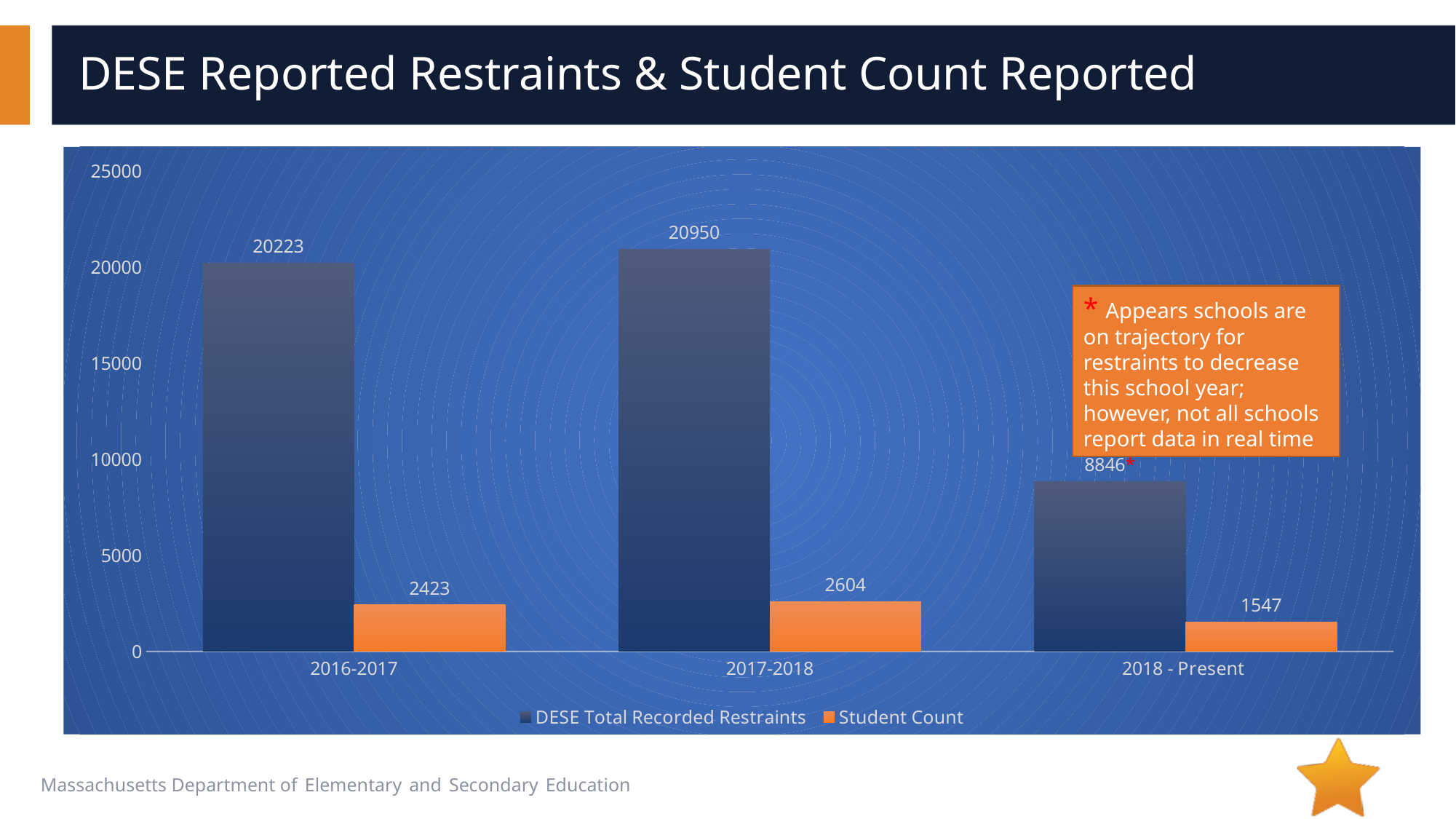
Which is larger: the Student Count for 2016-2017 or for 2017-2018? 2017-2018 How many series does the legend list? 2 What is the value of DESE Total Recorded Restraints for 2016-2017? 20223 Which period has the highest DESE Total Recorded Restraints? 2017-2018 What is the Student Count for 2018 - Present? 1547 What is the difference between DESE Total Recorded Restraints in 2017-2018 and 2016-2017? 727 What is the title of the slide? DESE Reported Restraints & Student Count Reported What is the value of DESE Total Recorded Restraints for 2018 - Present? 8846 Which period has the lowest Student Count? 2018 - Present What is the Student Count for 2017-2018? 2604 How many periods are shown on the x axis? 3 What kind of chart is shown on the slide? Bar chart